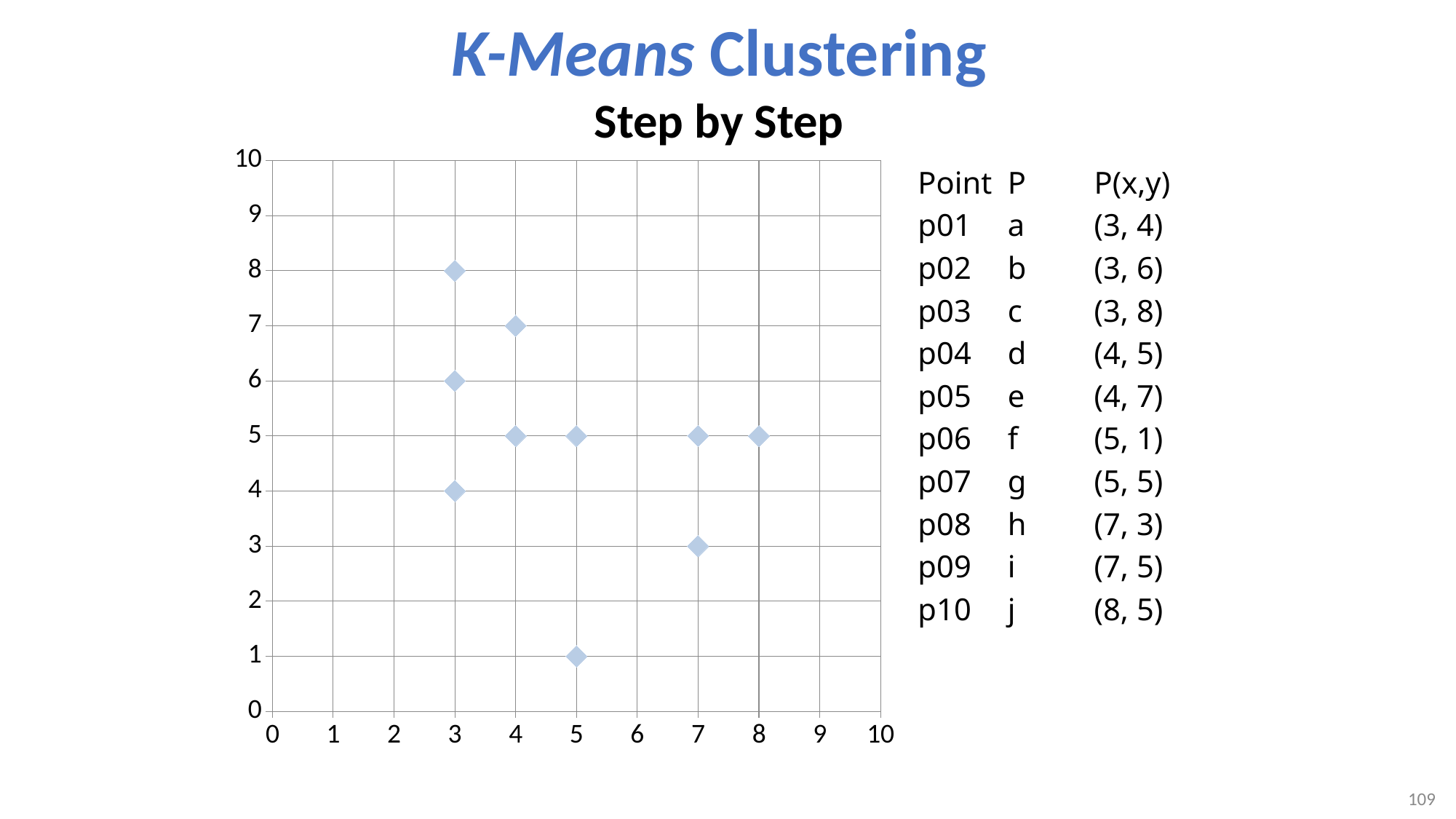
Is the y value of the lowest plotted point greater or less than 2? less How many data points are plotted on the chart? 10 How many plotted points have a y value of 5? 4 What are the coordinates of the point with the highest y value? (3, 8) What is the difference between the highest and lowest y values of the plotted points? 7 How many plotted points have an x value of 3? 3 What is the lowest y value among the plotted points? 1 What kind of chart is shown on the slide? scatter chart What are the coordinates of the point with the lowest y value? (5, 1) What is the highest y value among the plotted points? 8 What is the title shown directly above the chart? Step by Step What is the largest x value among the plotted points? 8